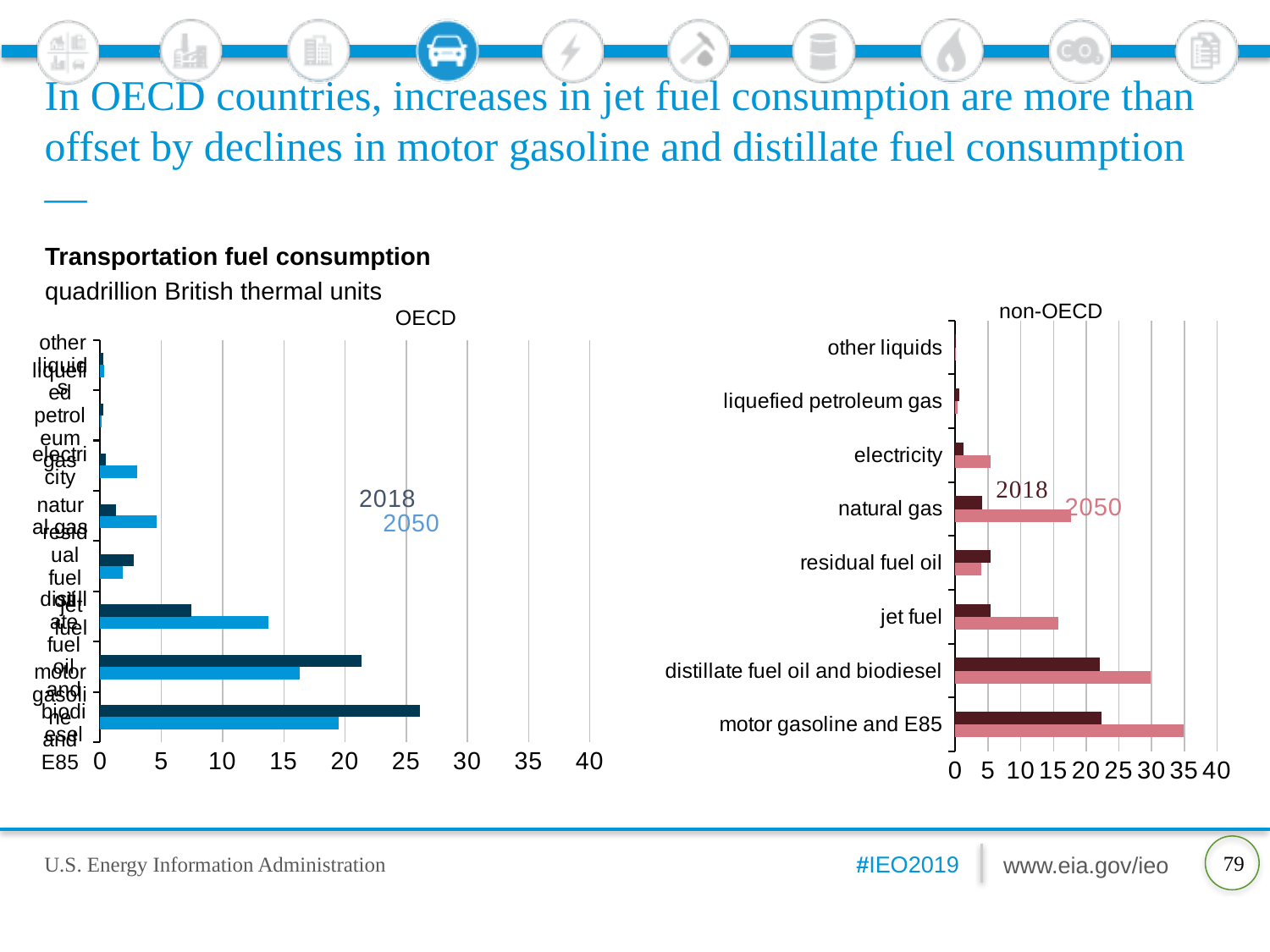
In the non-OECD chart, which category has the lowest values? other liquids What kind of chart is the non-OECD chart on the right of the slide? bar chart In the non-OECD chart, which is larger for 2050: distillate fuel oil and biodiesel or motor gasoline and E85? motor gasoline and E85 In the non-OECD chart, is the 2050 value for jet fuel greater or less than 10? greater How many series does the non-OECD chart show? 2 What unit is given for the transportation fuel consumption charts? quadrillion British thermal units In the non-OECD chart, is the 2050 value for motor gasoline and E85 greater or less than 30? greater What are the two series labels shown on the OECD chart? 2018 and 2050 In the non-OECD chart, is the 2018 value for electricity greater or less than 5? less How many fuel categories are listed on the non-OECD chart? 8 In the non-OECD chart, which is larger for 2050: jet fuel or residual fuel oil? jet fuel In the non-OECD chart, which category has the highest 2050 value? motor gasoline and E85